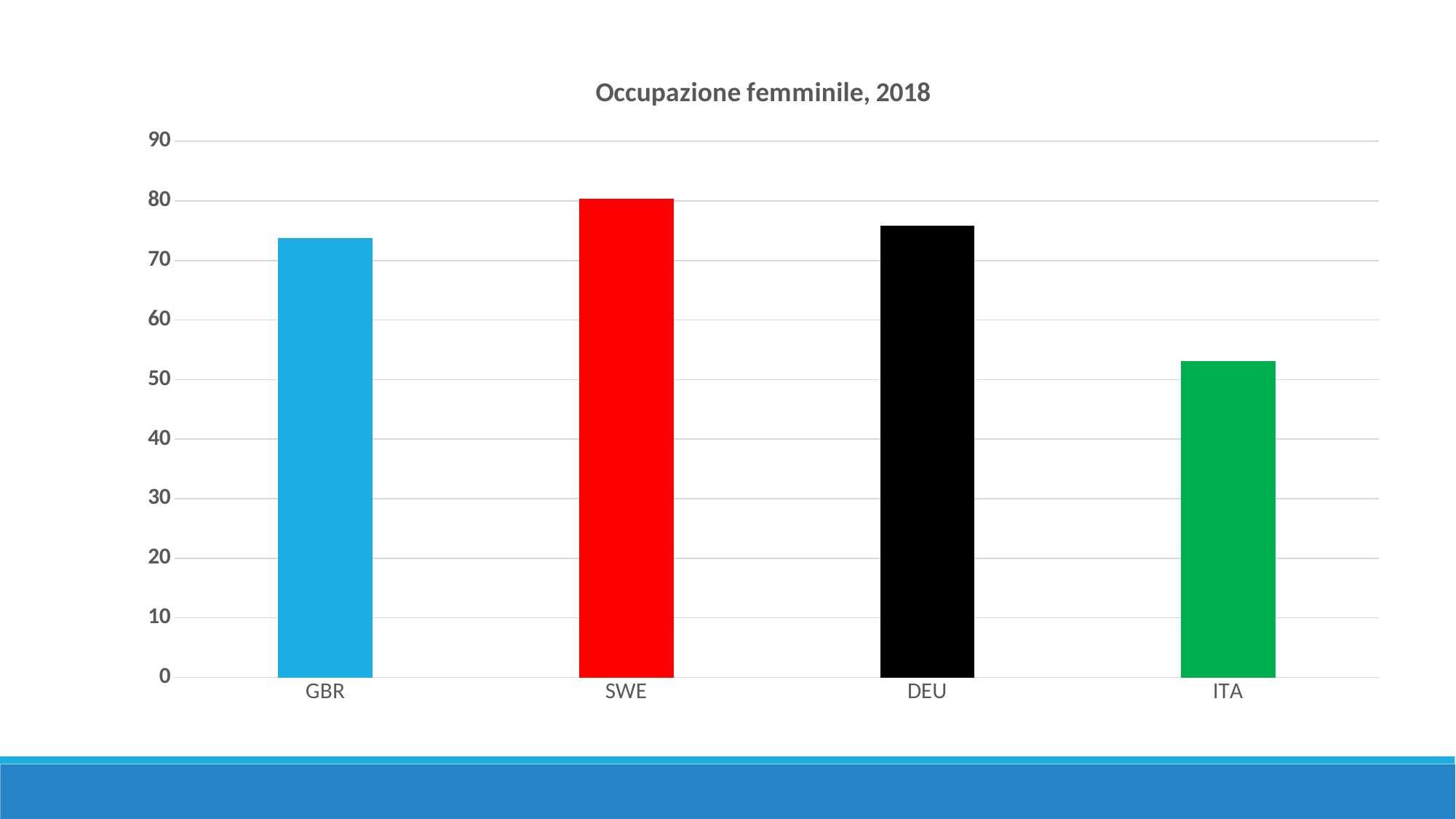
Is the value for DEU greater or less than 80? less What is the title of the chart? Occupazione femminile, 2018 Which country has the lowest value? ITA What colour is the bar for SWE? red Which is larger, the value for DEU or the value for GBR? DEU Is the value for GBR greater or less than 70? greater Which is larger, the value for ITA or the value for SWE? SWE How many countries are shown in the chart? 4 Is the value for ITA greater or less than 50? greater What kind of chart is shown on the slide? bar chart Which country has the highest value? SWE